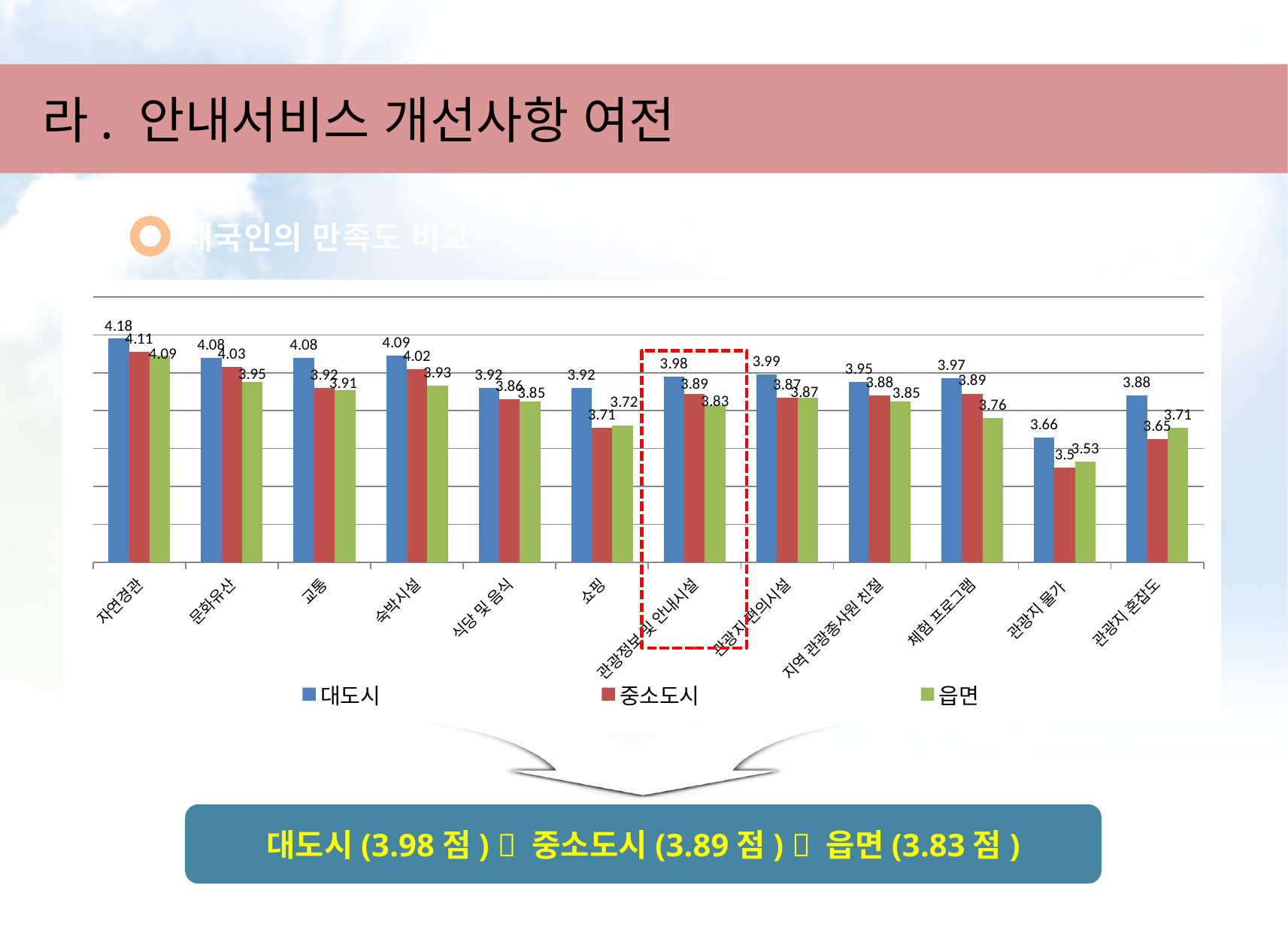
Which category on the chart is highlighted with a red dashed box? 관광정보 및 안내시설 What type of chart is shown on the slide? bar chart What is the value for 대도시 in the 자연경관 category? 4.18 Which category has the highest value for the 대도시 series? 자연경관 What is the difference between the 대도시 and 읍면 values in the 관광정보 및 안내시설 category? 0.15 What is the value for 중소도시 in the 관광지 물가 category? 3.5 How many series does the legend list? 3 Which category has the lowest value for the 읍면 series? 관광지 물가 In the 쇼핑 category, which is larger: the 대도시 value or the 중소도시 value? 대도시 What is the difference between the 대도시 and 중소도시 values in the 관광지 혼잡도 category? 0.23 What is the value for 읍면 in the 관광정보 및 안내시설 category? 3.83 How many categories are shown on the x axis? 12